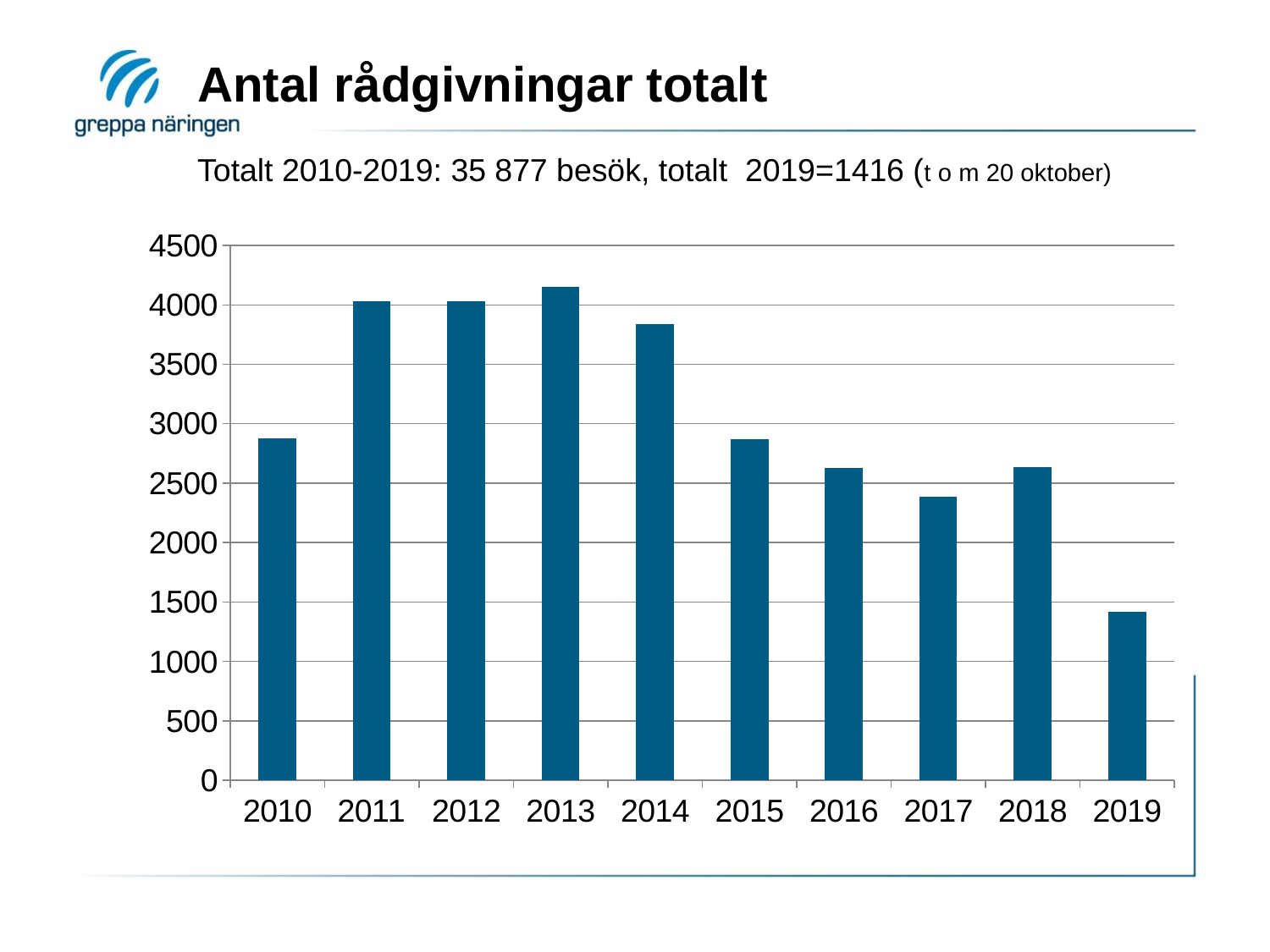
What is the total number of rådgivningar for 2019 according to the slide? 1416 How many years are shown on the x axis of the chart? 10 What kind of chart is shown on the slide? bar chart Is the value for 2014 greater or less than 3500? greater Is the value for 2017 greater or less than 2500? less Which year has the lowest number of rådgivningar? 2019 Do the values rise or fall from 2013 to 2017? fall Which year has the larger value, 2014 or 2015? 2014 Which year has the highest number of rådgivningar? 2013 Is the value for 2010 greater or less than 3000? less What is the title of the slide containing the chart? Antal rådgivningar totalt